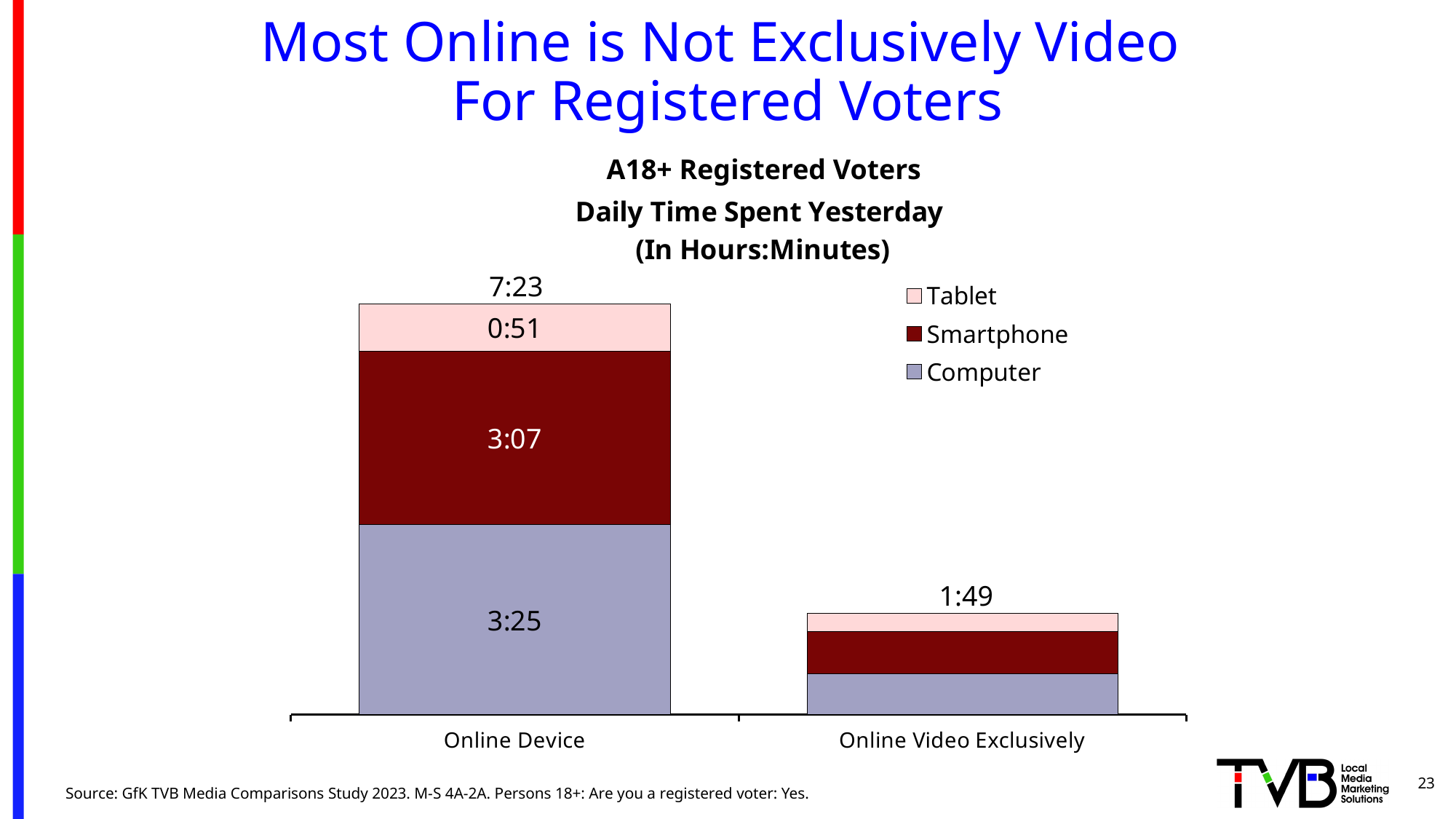
Within the Online Device bar, which device accounts for the most time? Computer What is the total daily time spent for Online Device? 7:23 What kind of chart is shown on the slide? Stacked bar chart How many categories are shown on the x axis? 2 How many series does the legend list? 3 Which category has the larger total time, Online Device or Online Video Exclusively? Online Device What is the total daily time spent for Online Video Exclusively? 1:49 How much time is shown for Computer in the Online Device bar? 3:25 What is the difference between the Online Device total and the Online Video Exclusively total? 5:34 Within the Online Device bar, which device accounts for the least time? Tablet How much time is shown for Tablet in the Online Device bar? 0:51 How much time is shown for Smartphone in the Online Device bar? 3:07